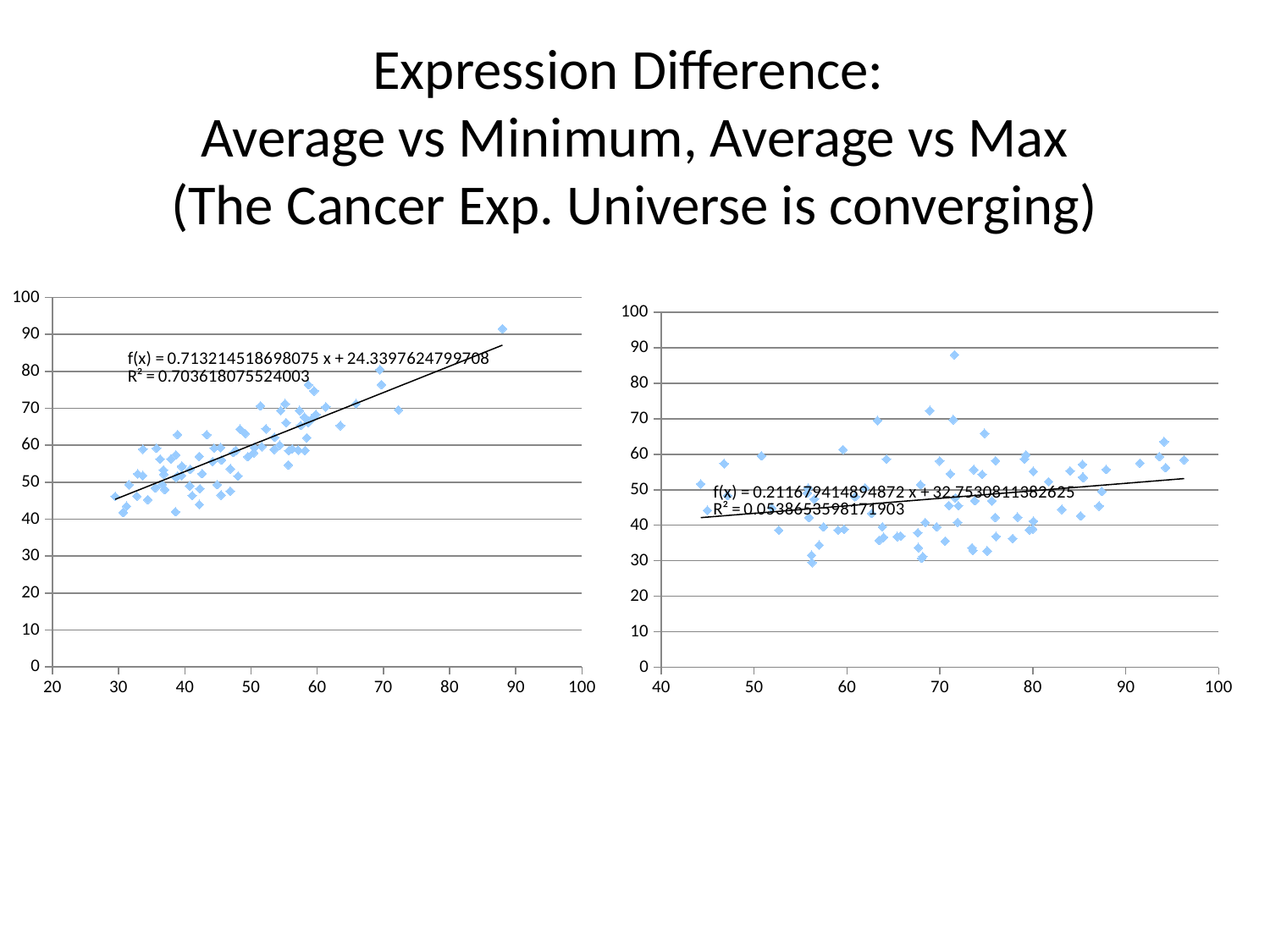
What kind of chart is the right chart on the slide? scatter chart In the left chart, what R² value is printed for the trendline? R² = 0.703618075524003 In the left chart, what is the slope of the printed trendline equation? 0.713214518698075 How many charts are shown on the slide? 2 In the left chart, do the points generally rise or fall as the x value increases? rise In the right chart, what is the intercept of the printed trendline equation? 32.7530811382625 In the right chart, is the highest plotted y value greater or less than 80? greater In the left chart, is the highest plotted y value greater or less than 80? greater What kind of chart is the left chart on the slide? scatter chart Which chart has the higher R² value, the left chart or the right chart? the left chart What is the lowest x-axis tick value shown on the right chart? 40 In the right chart, what R² value is printed for the trendline? R² = 0.0538653598171903